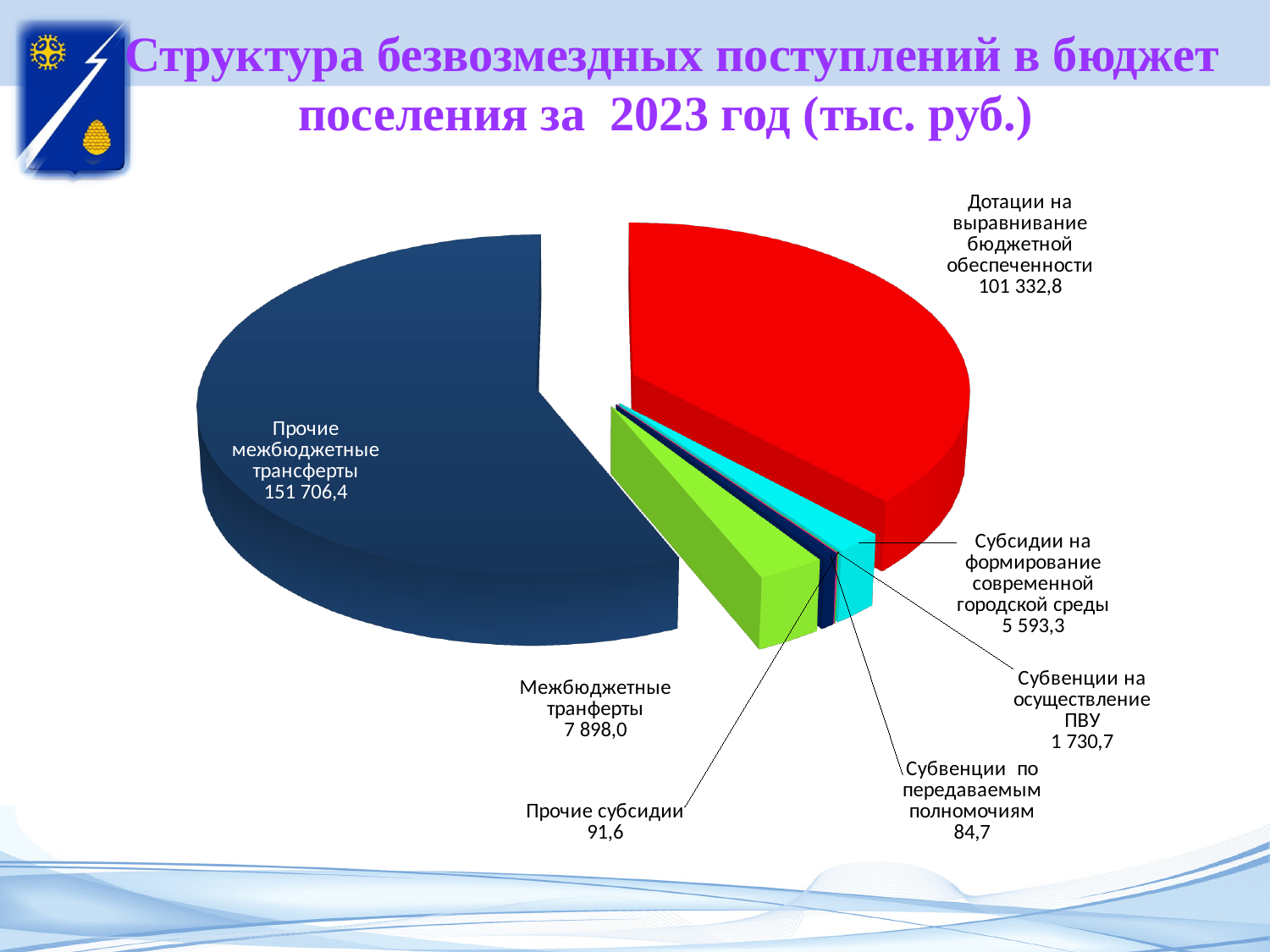
How many categories does the pie chart show? 7 Which category has the smallest value? Субвенции по передаваемым полномочиям What is the difference between Прочие межбюджетные трансферты and Дотации на выравнивание бюджетной обеспеченности? 50 373,6 Which is larger: Межбюджетные трансферты or Субсидии на формирование современной городской среды? Межбюджетные трансферты Which category has the largest value? Прочие межбюджетные трансферты What is the value for Межбюджетные трансферты? 7 898,0 What is the value for Субвенции на осуществление ПВУ? 1 730,7 What is the value for Субсидии на формирование современной городской среды? 5 593,3 What year does the chart title refer to? 2023 What is the value for Дотации на выравнивание бюджетной обеспеченности? 101 332,8 What type of chart is shown on the slide? Pie chart What is the value for Прочие межбюджетные трансферты? 151 706,4